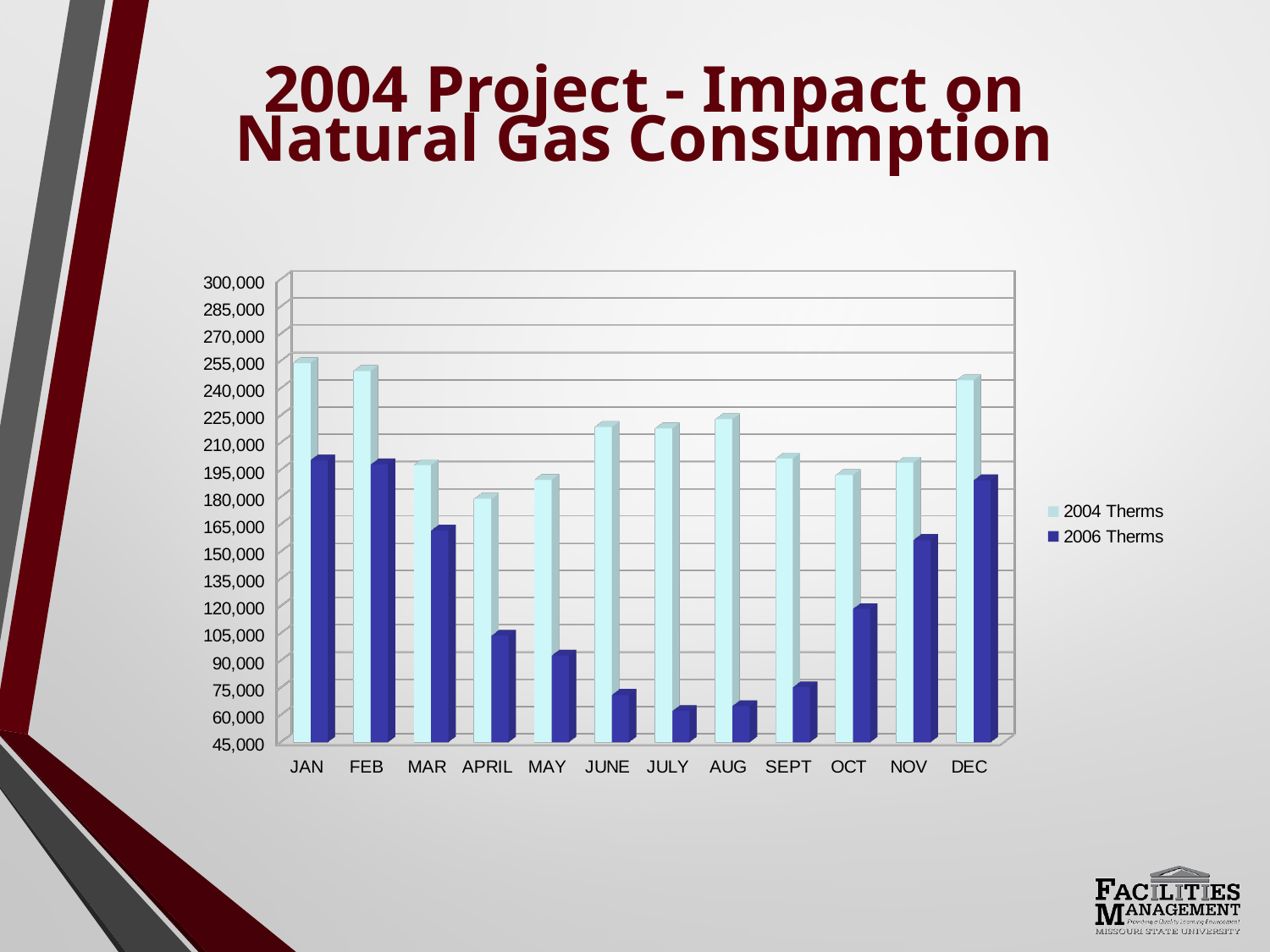
Which month has the lowest 2004 Therms value? APRIL Is the 2006 Therms value for JULY greater or less than 75,000? less What are the two series named in the legend? 2004 Therms and 2006 Therms Is the 2004 Therms value for JUNE greater or less than 210,000? greater How many series does the legend list? 2 How many months are shown on the x axis? 12 Which is larger for 2006 Therms, SEPT or OCT? OCT For JAN, which series has the larger value, 2004 Therms or 2006 Therms? 2004 Therms Is the 2006 Therms value for APRIL greater or less than 120,000? less Do the 2006 Therms values rise or fall from JAN to JULY? fall What kind of chart is shown on the slide? bar chart